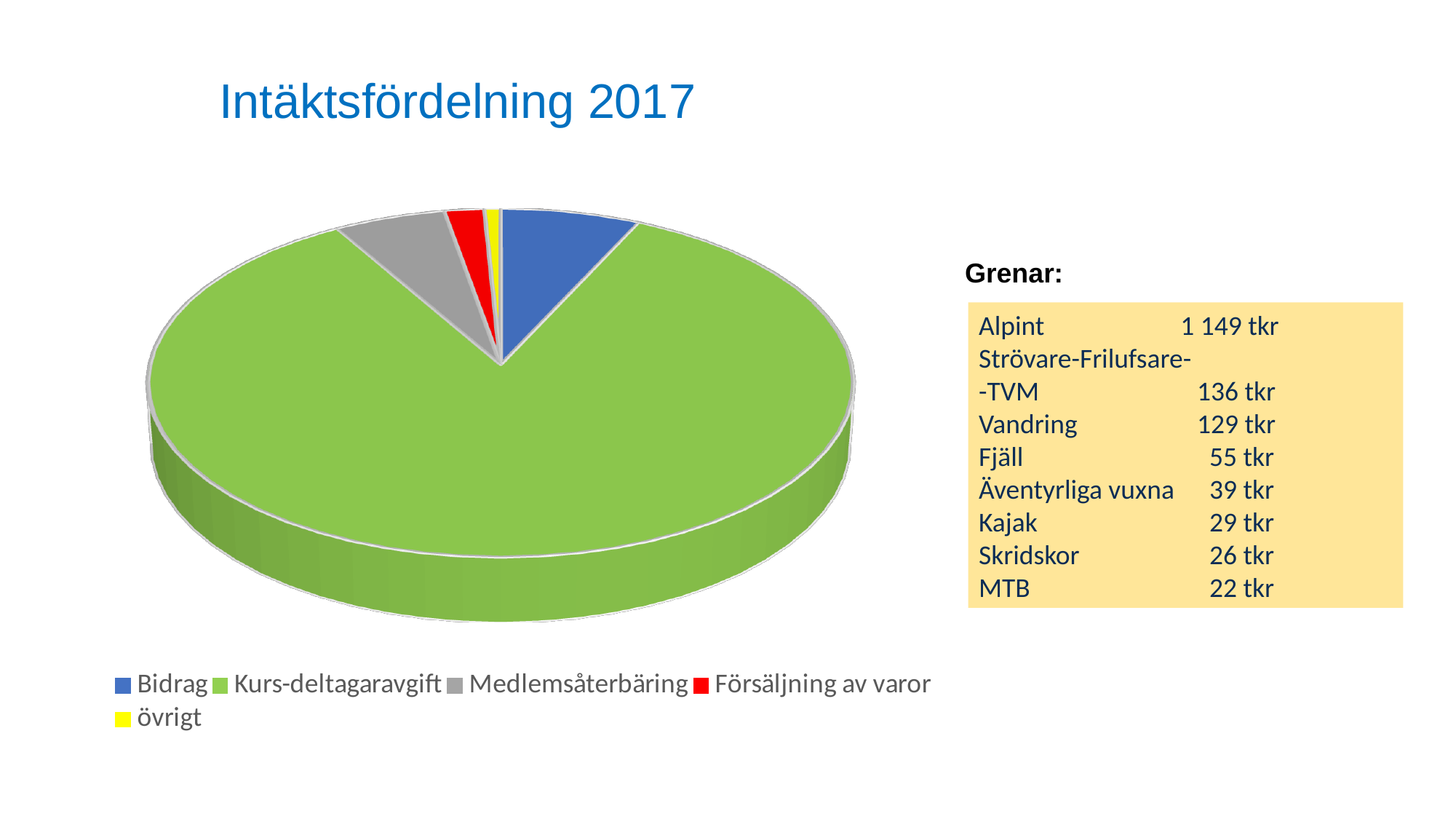
Which category is shown in red in the pie chart? Försäljning av varor How many categories does the pie chart's legend list? 5 Which slice is larger in the pie chart, Kurs-deltagaravgift or Bidrag? Kurs-deltagaravgift Which category has the smallest slice in the pie chart? övrigt Which slice is larger in the pie chart, Medlemsåterbäring or övrigt? Medlemsåterbäring Which category has the largest slice in the pie chart? Kurs-deltagaravgift Which slice is larger in the pie chart, Bidrag or Försäljning av varor? Bidrag What kind of chart is shown on the slide? pie chart What is the title of the slide containing the pie chart? Intäktsfördelning 2017 What colour represents Kurs-deltagaravgift in the pie chart? green